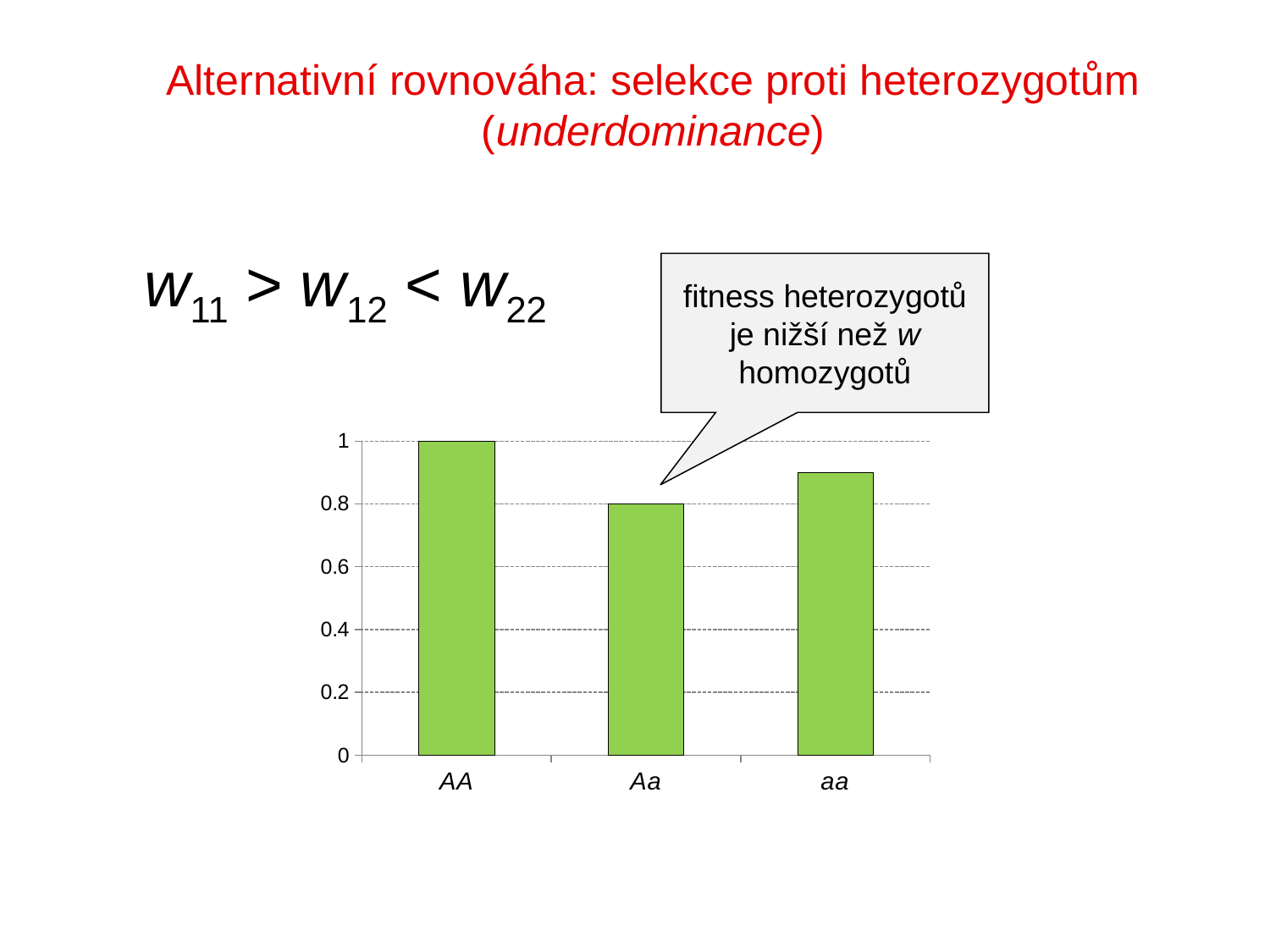
Is the value for aa greater or less than 0.8? greater Which category has the lowest bar in the chart? Aa Which is larger, the value for Aa or the value for aa? aa What is the value for AA in the chart? 1 What is the difference between the values for AA and Aa? 0.2 Is the value for aa greater or less than 1? less What colour are the bars in the chart? green What kind of chart is shown on the slide? bar chart How many categories are shown on the x axis of the chart? 3 Which category has the highest bar in the chart? AA